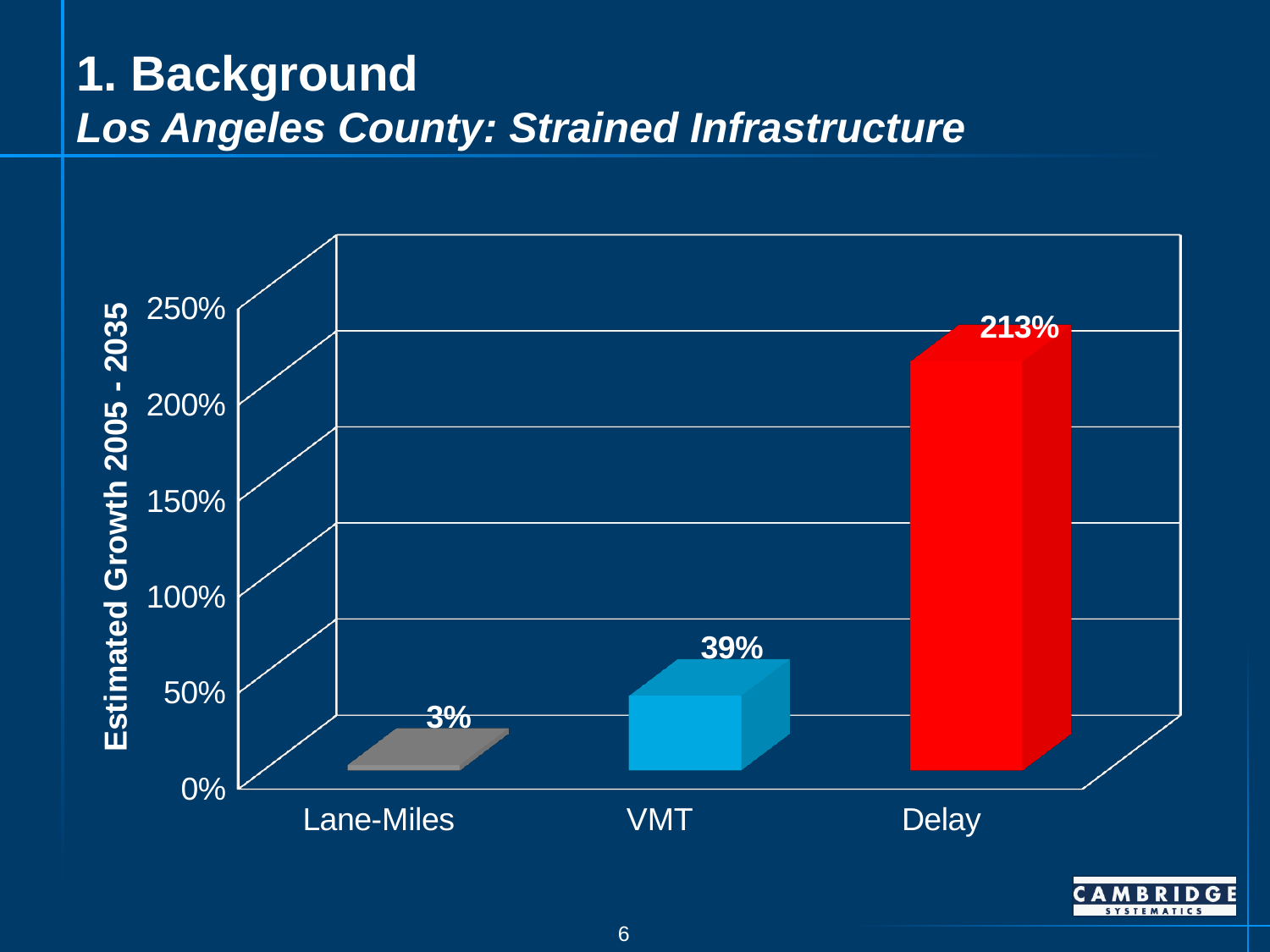
How many categories are shown on the chart? 3 What is the difference in estimated growth between VMT and Lane-Miles? 36% What is the difference in estimated growth between Delay and VMT? 174% What is the label of the vertical axis? Estimated Growth 2005 - 2035 Which category has the lowest estimated growth? Lane-Miles What is the estimated growth for VMT? 39% Which has a larger estimated growth, VMT or Lane-Miles? VMT What is the estimated growth for Delay? 213% Which category has the highest estimated growth? Delay Is the estimated growth for Delay greater or less than 200%? greater What kind of chart is shown on the slide? Bar chart What is the estimated growth for Lane-Miles? 3%